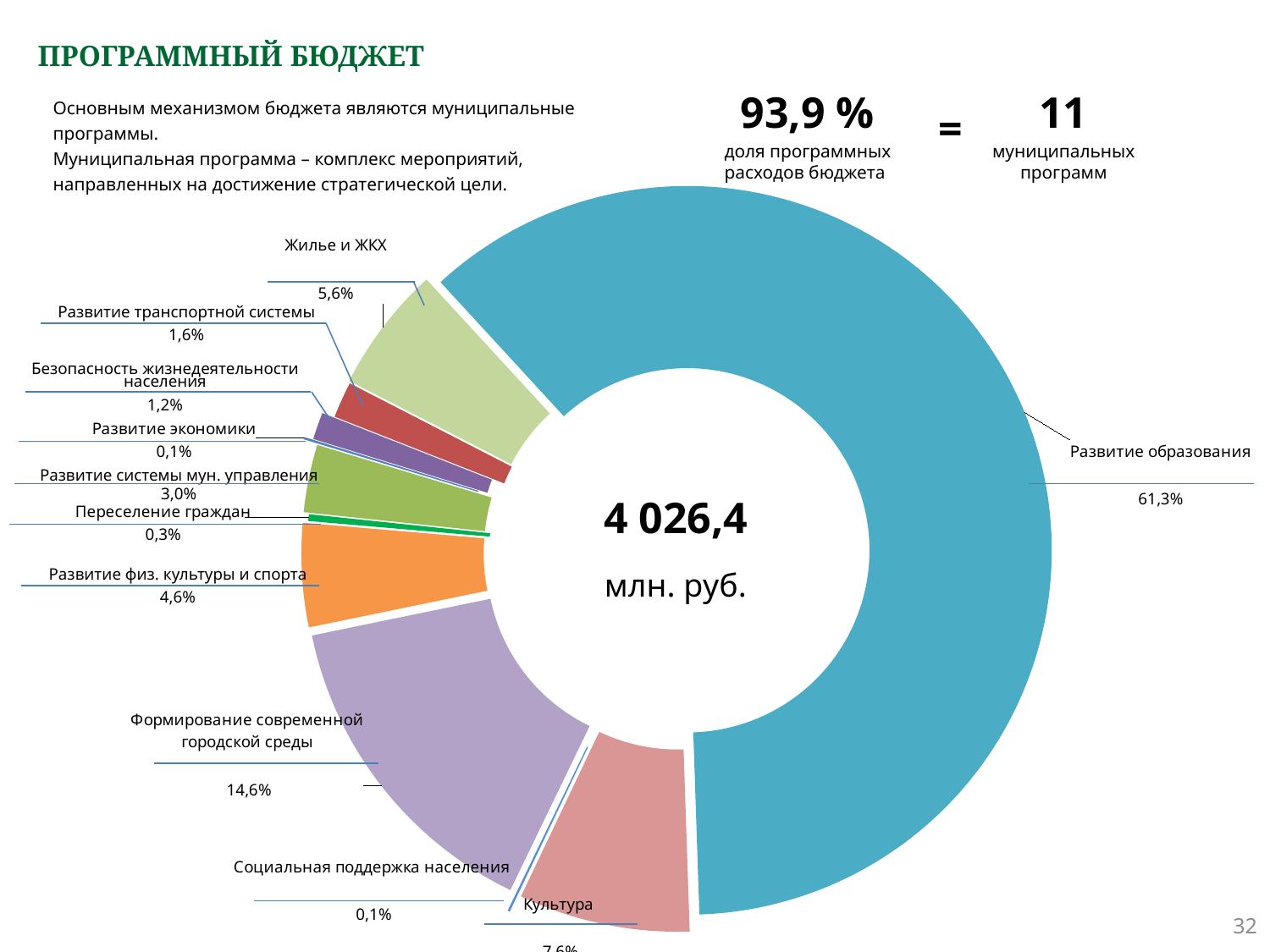
How many categories are shown in the pie chart? 11 What kind of chart is shown on the slide? Pie chart (donut) What is the value shown for Жилье и ЖКХ? 5,6% Which is larger, Жилье и ЖКХ or Развитие транспортной системы? Жилье и ЖКХ Which category has the largest share of the pie chart? Развитие образования What is the difference between the shares of Развитие образования and Формирование современной городской среды? 46,7% What is the value shown for Развитие системы мун. управления? 3,0% What is the difference between the shares of Жилье и ЖКХ and Развитие физ. культуры и спорта? 1,0% What share of the pie chart does Развитие образования account for? 61,3% What is the value shown for Формирование современной городской среды? 14,6% What total value is printed in the centre of the chart? 4 026,4 млн. руб. What is the value shown for Развитие физ. культуры и спорта? 4,6%